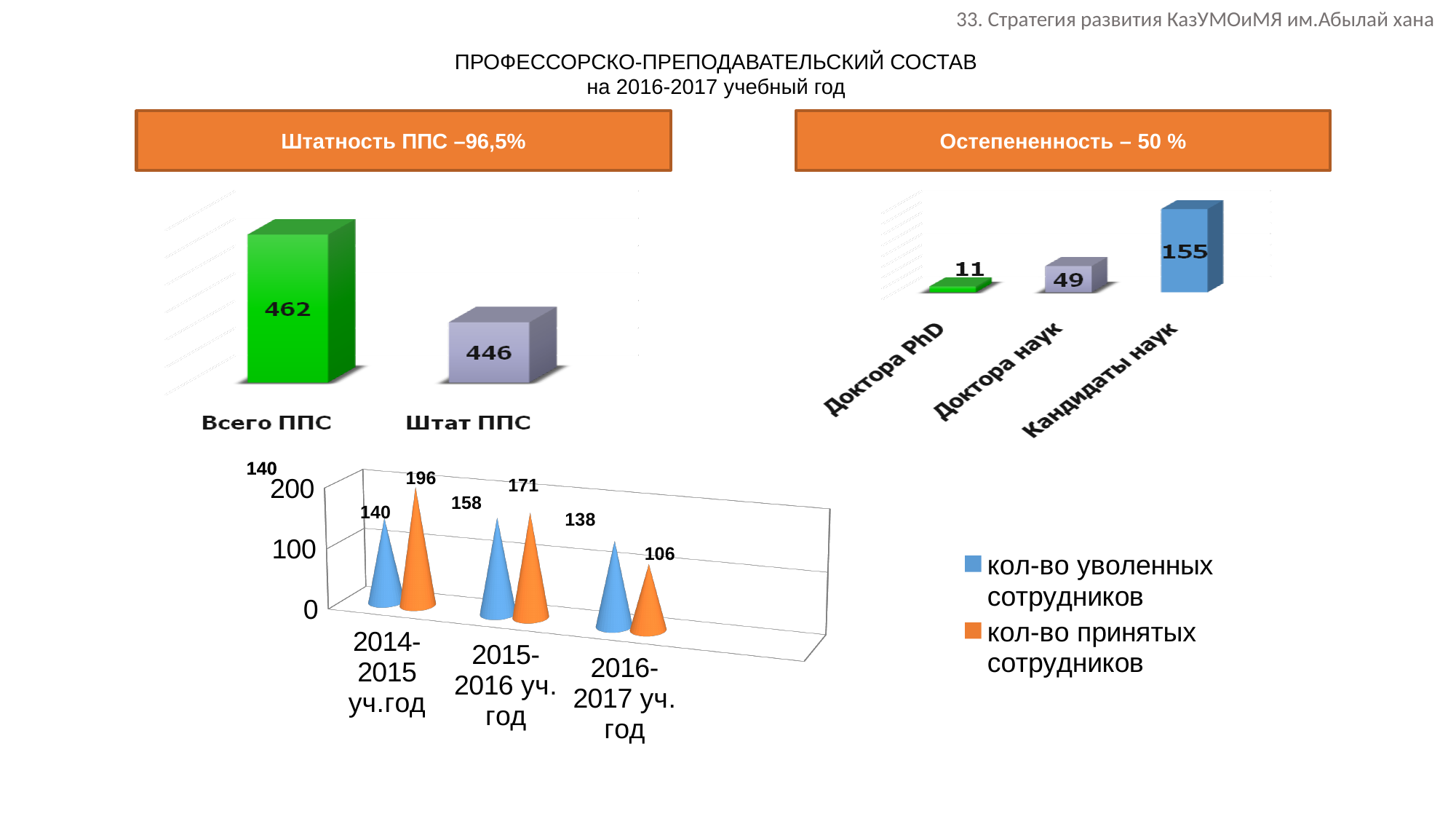
In the bottom chart, which is larger for 2016-2017 уч. год: 'кол-во уволенных сотрудников' or 'кол-во принятых сотрудников'? кол-во уволенных сотрудников In the top-left chart under 'Штатность ППС', what is the value for 'Штат ППС'? 446 In the top-right chart under 'Остепененность', what is the value for 'Доктора наук'? 49 In the bottom chart, does the value of 'кол-во принятых сотрудников' rise or fall from 2014-2015 to 2016-2017? fall In the bottom chart, what is the value of 'кол-во принятых сотрудников' for 2014-2015 уч.год? 196 In the bottom chart, what is the value of 'кол-во уволенных сотрудников' for 2016-2017 уч. год? 138 In the top-left chart under 'Штатность ППС', what is the difference between 'Всего ППС' and 'Штат ППС'? 16 In the top-right chart under 'Остепененность', how many categories are shown? 3 In the top-left chart under 'Штатность ППС', what is the value for 'Всего ППС'? 462 In the top-right chart under 'Остепененность', which category has the lowest value? Доктора PhD In the top-right chart under 'Остепененность', which category has the highest value? Кандидаты наук In the bottom chart, how many series does the legend list? 2